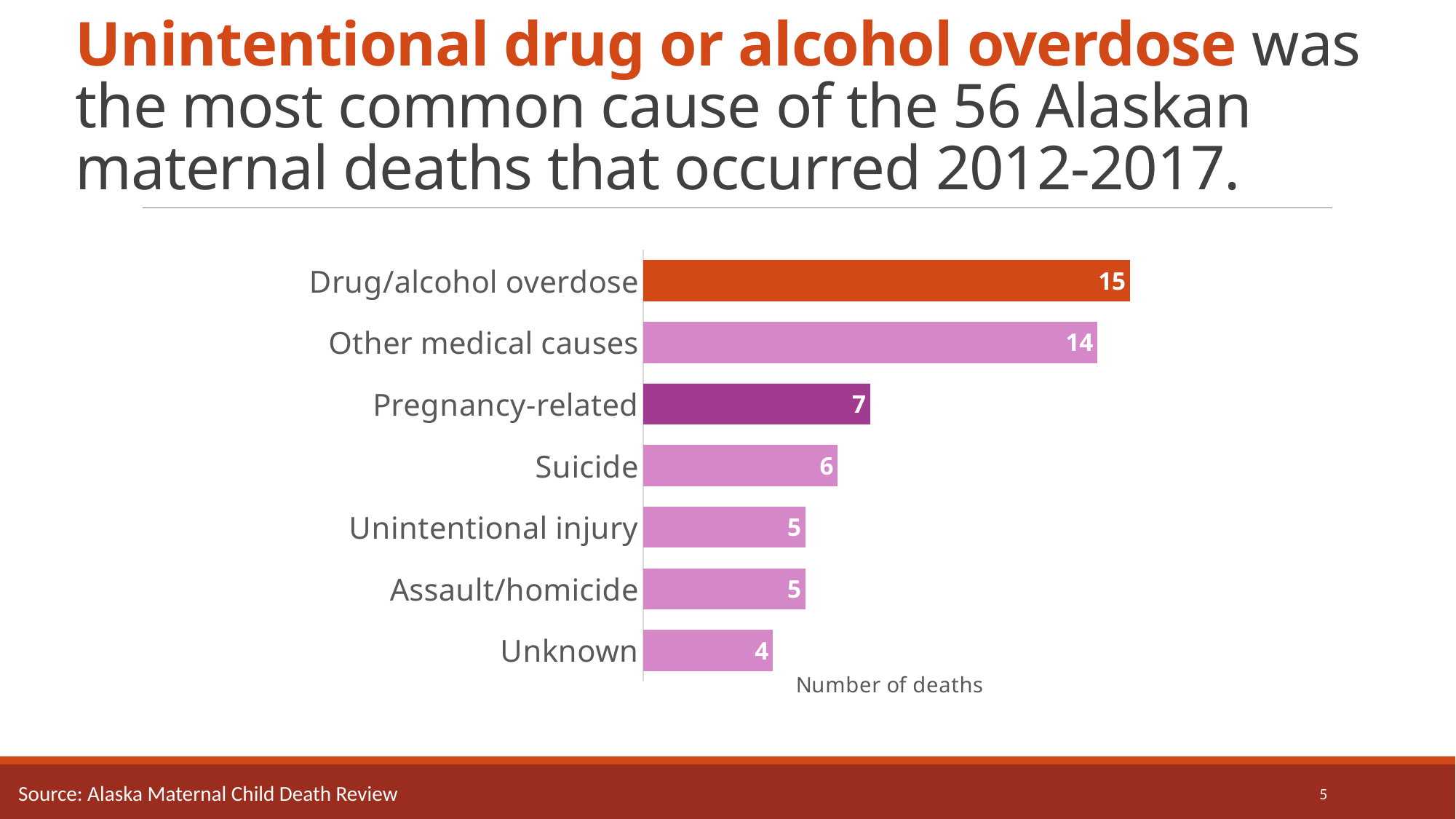
Which cause has the highest number of deaths? Drug/alcohol overdose How many deaths are attributed to Pregnancy-related causes? 7 Which cause has the lowest number of deaths? Unknown What is the difference in deaths between Drug/alcohol overdose and Other medical causes? 1 What kind of chart is shown on the slide? Bar chart What is the difference in deaths between Pregnancy-related and Unknown? 3 What is the label on the horizontal axis of the chart? Number of deaths How many deaths are shown for Drug/alcohol overdose? 15 How many causes of death are listed in the chart? 7 Which has more deaths, Suicide or Unintentional injury? Suicide What is the value for Unknown? 4 What is the number of deaths for Other medical causes? 14